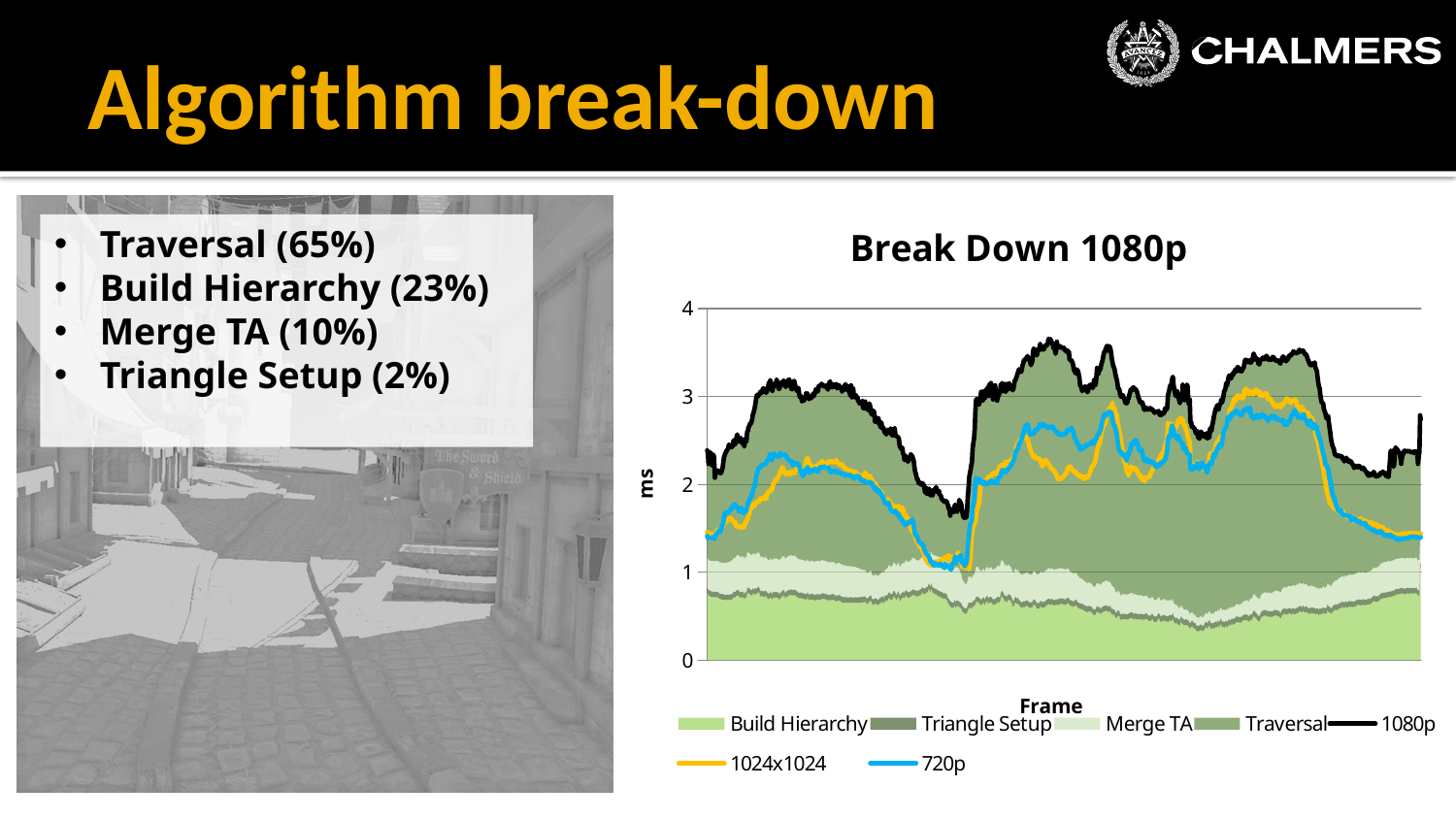
What kind of chart is shown under the title "Break Down 1080p"? area chart What is the highest tick value shown on the vertical axis? 4 What is the title of the chart on the slide? Break Down 1080p How many entries does the chart's legend list? 7 Which stacked area occupies the largest share of the chart? Traversal Is the lowest value of the 1080p line greater or less than 1? greater Is the peak value of the 1080p line greater or less than 3? greater What is the label on the chart's vertical axis? ms Is the peak value of the 1080p line greater or less than 4? less Which line reaches higher values overall, 1080p or 720p? 1080p Which stacked area is the thinnest in the chart? Triangle Setup